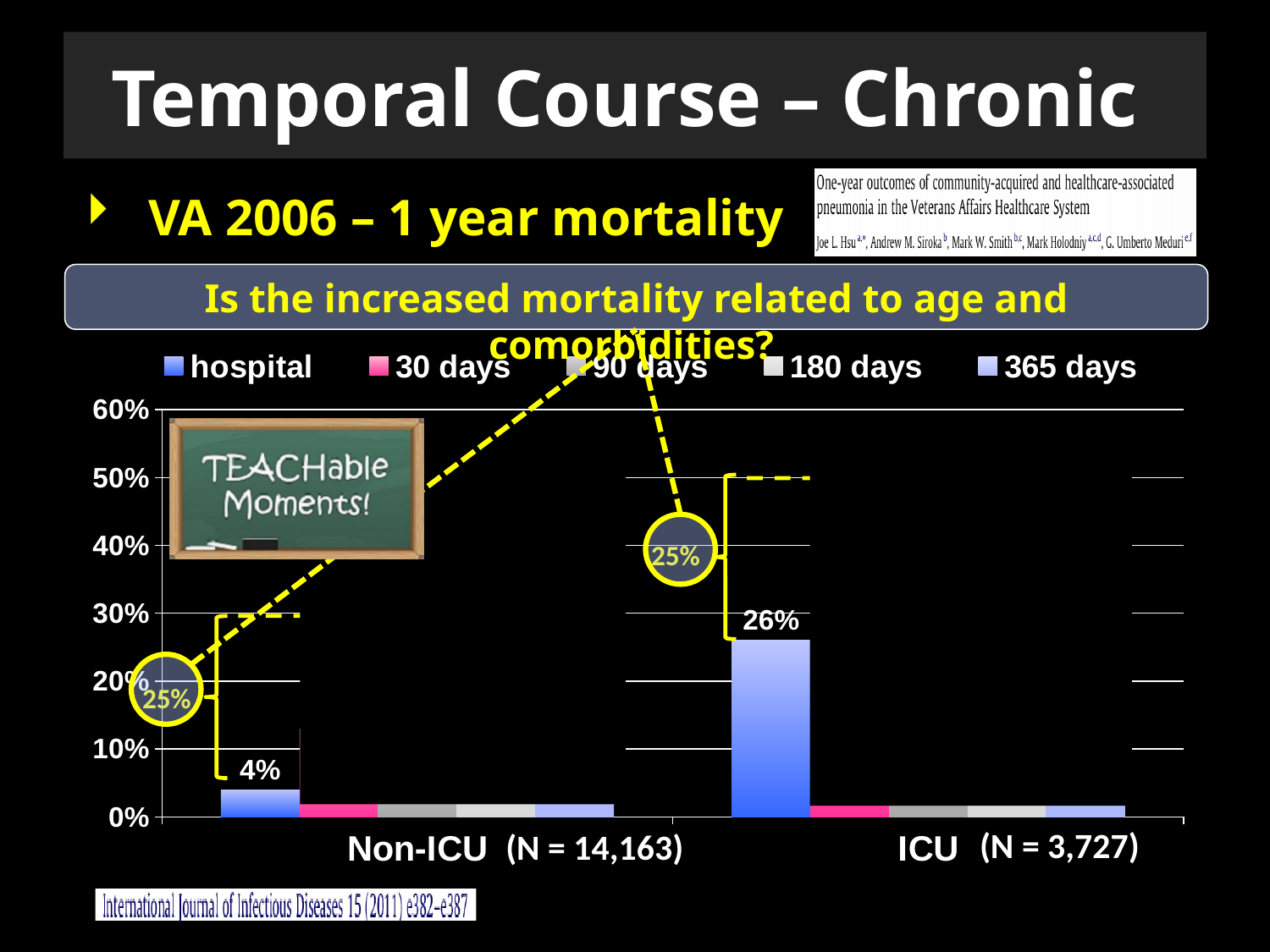
What kind of chart is shown on the slide? Bar chart What is the first entry in the chart legend? hospital What is the difference between the hospital mortality values for ICU and Non-ICU? 22 percentage points How many series does the legend list? 5 Is the hospital value for the Non-ICU group greater or less than 10%? less How many groups are shown on the x axis? 2 Which group has the larger hospital mortality value, ICU or Non-ICU? ICU What is the sample size (N) shown for the ICU group? N = 3,727 Is the hospital value for the ICU group greater or less than 20%? greater What is the hospital mortality value for the ICU group? 26% What is the hospital mortality value for the Non-ICU group? 4%